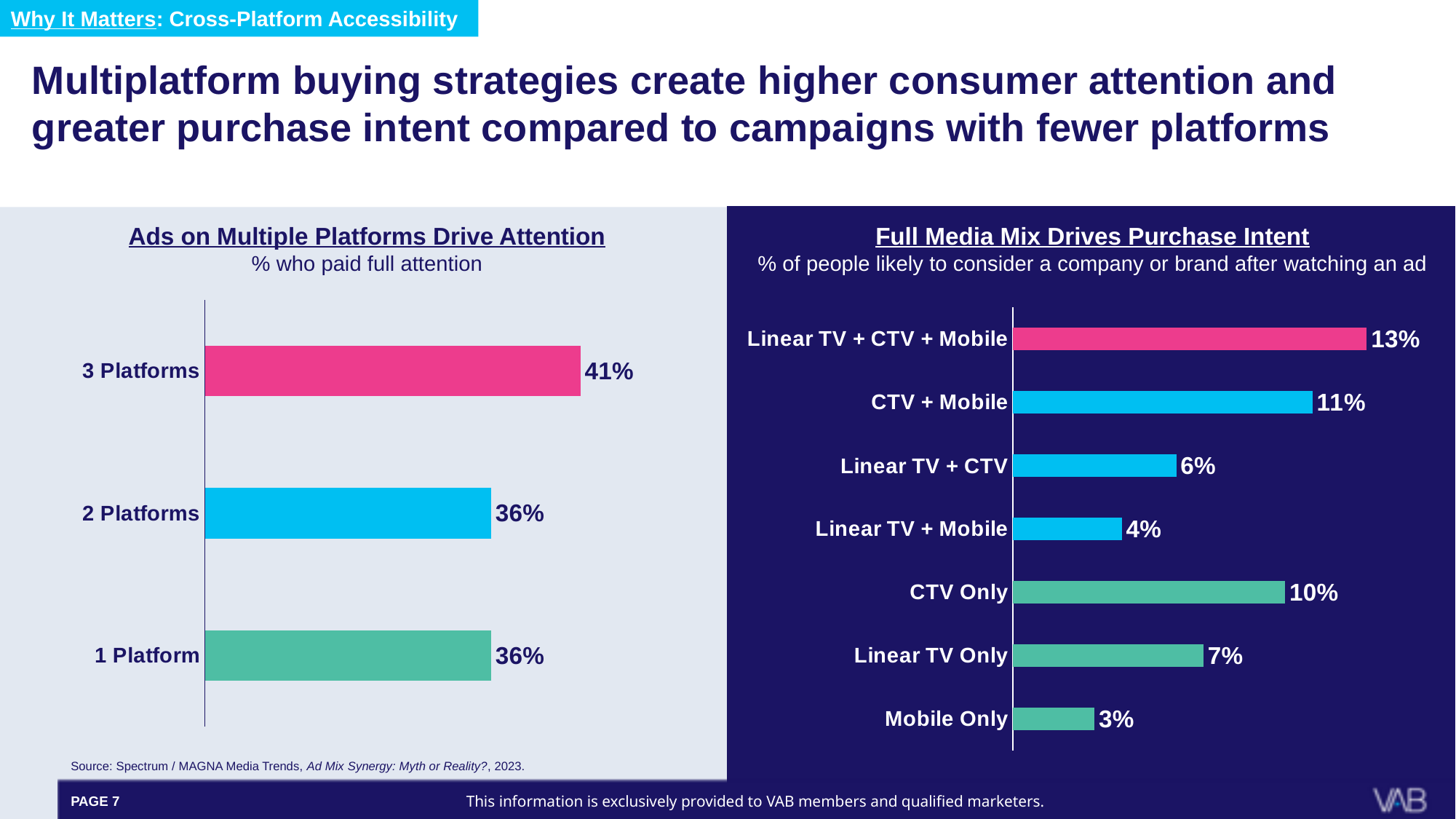
In the 'Ads on Multiple Platforms Drive Attention' chart, what is the value for 3 Platforms? 41% In the 'Full Media Mix Drives Purchase Intent' chart, which is larger: CTV Only or Linear TV + CTV? CTV Only In the 'Ads on Multiple Platforms Drive Attention' chart, which category has the highest value? 3 Platforms In the 'Ads on Multiple Platforms Drive Attention' chart, what is the difference between 3 Platforms and 2 Platforms? 5% In the 'Full Media Mix Drives Purchase Intent' chart, what is the difference between Linear TV + CTV + Mobile and Linear TV + Mobile? 9% In the 'Full Media Mix Drives Purchase Intent' chart, what is the value for CTV + Mobile? 11% What type of chart is the 'Full Media Mix Drives Purchase Intent' chart? Bar chart In the 'Ads on Multiple Platforms Drive Attention' chart, what is the value for 1 Platform? 36% In the 'Full Media Mix Drives Purchase Intent' chart, which category has the highest value? Linear TV + CTV + Mobile In the 'Ads on Multiple Platforms Drive Attention' chart, how many categories are shown? 3 In the 'Full Media Mix Drives Purchase Intent' chart, which category has the lowest value? Mobile Only In the 'Full Media Mix Drives Purchase Intent' chart, what is the value for Linear TV Only? 7%